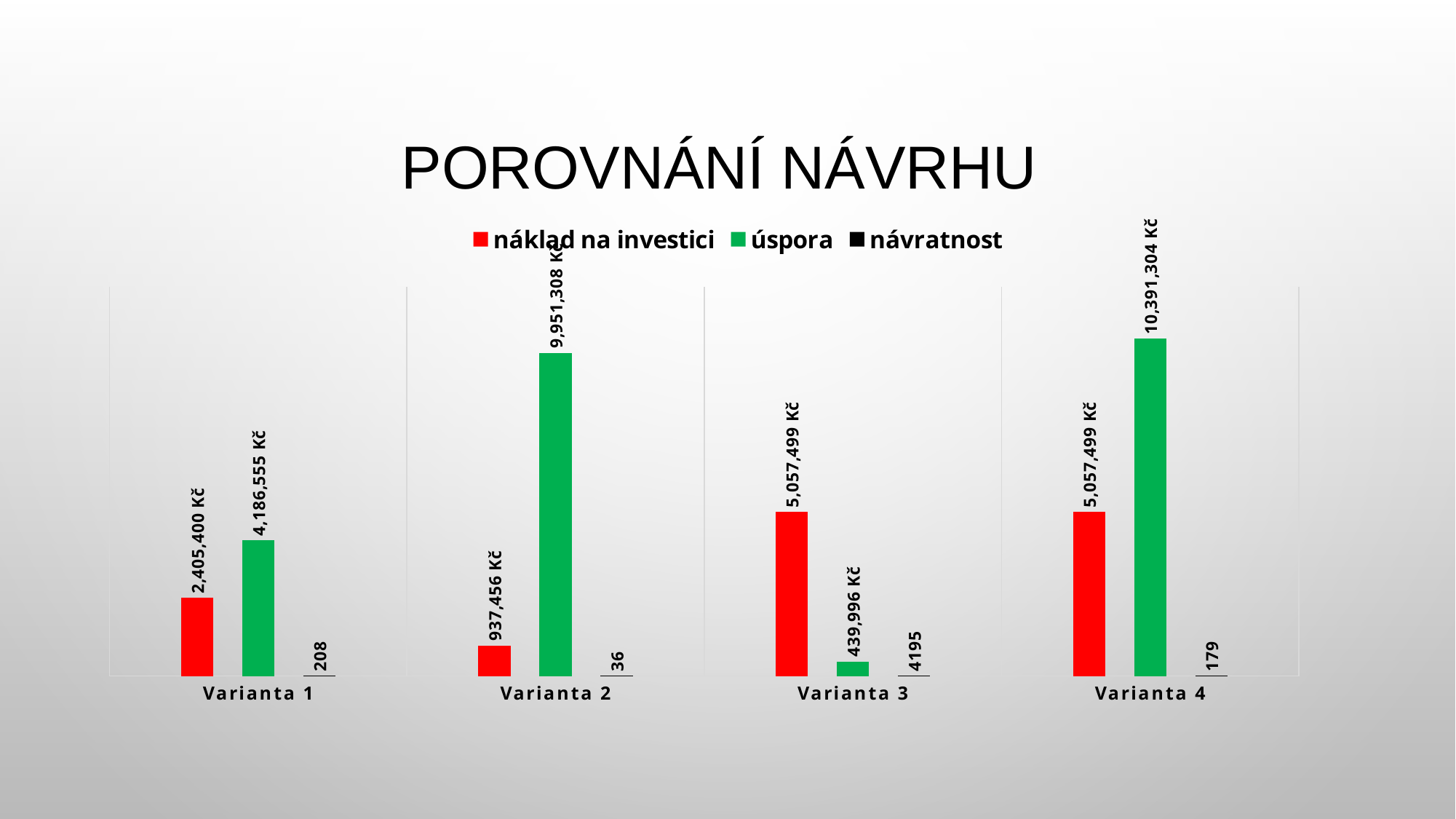
How many series does the legend list? 3 Which variant has the highest úspora value? Varianta 4 What is the návratnost value for Varianta 3? 4195 How many variants (categories) are shown on the chart? 4 Which variant has the lowest náklad na investici value? Varianta 2 What is the úspora value for Varianta 2? 9,951,308 Kč What type of chart is shown on the slide? bar chart What is the úspora value for Varianta 4? 10,391,304 Kč What is the difference between the úspora values of Varianta 4 and Varianta 2? 439,996 Kč Which variant has the highest návratnost value? Varianta 3 Which is larger for Varianta 3: náklad na investici or úspora? náklad na investici What is the náklad na investici value for Varianta 1? 2,405,400 Kč